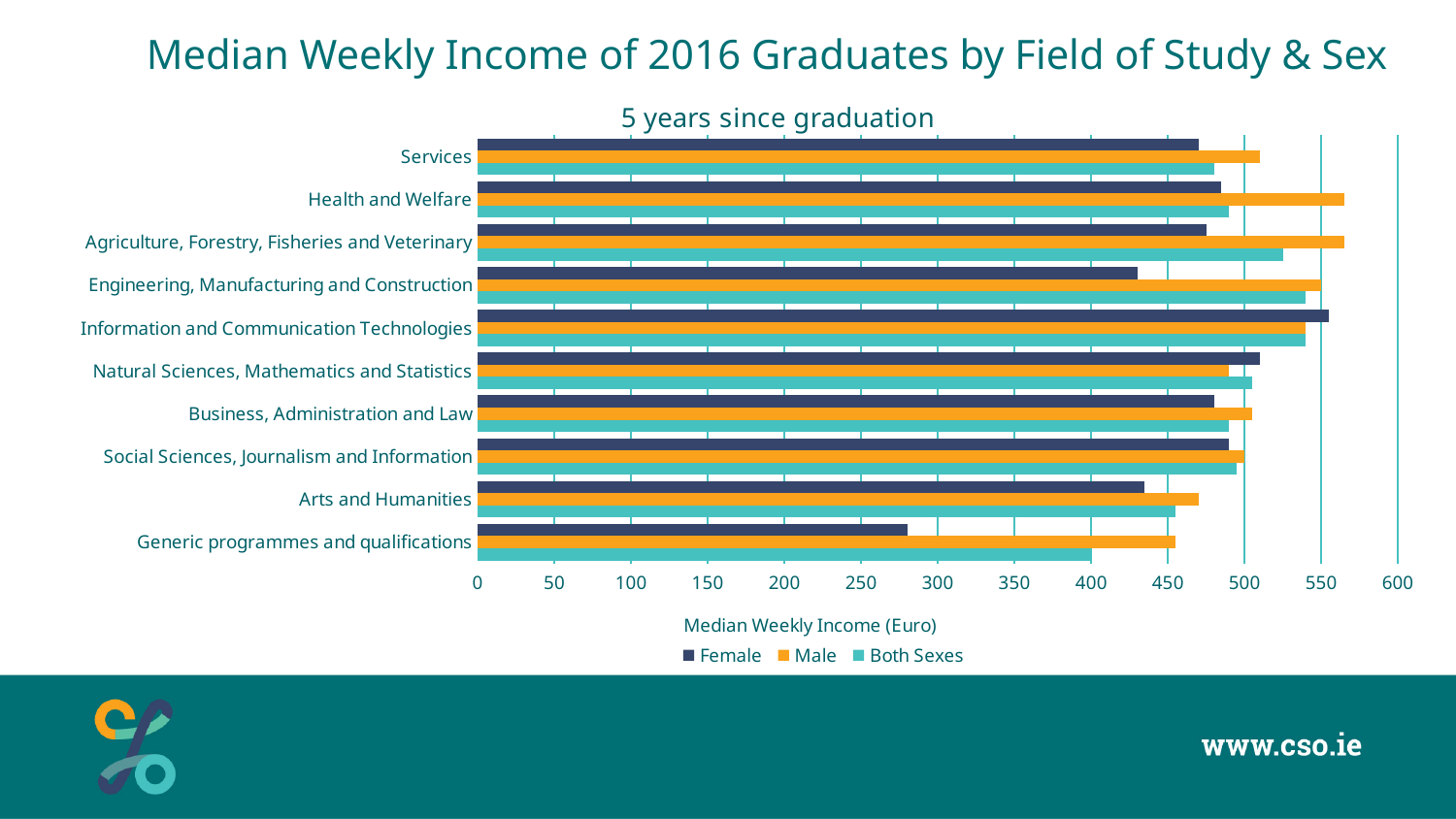
What kind of chart is shown on the slide? Bar chart What subtitle appears above the chart? 5 years since graduation How many fields of study are shown on the chart? 10 Which field of study has the lowest Female median weekly income? Generic programmes and qualifications How many series does the legend list? 3 Which field of study has the highest Female median weekly income? Information and Communication Technologies Is the Female value for Generic programmes and qualifications greater or less than 300? less Is the Both Sexes value for Generic programmes and qualifications greater or less than 450? less Is the Male value for Health and Welfare greater or less than 550? greater For Engineering, Manufacturing and Construction, which is larger: the Female value or the Male value? Male What is the title of the horizontal axis? Median Weekly Income (Euro) For Generic programmes and qualifications, which is larger: the Male value or the Female value? Male